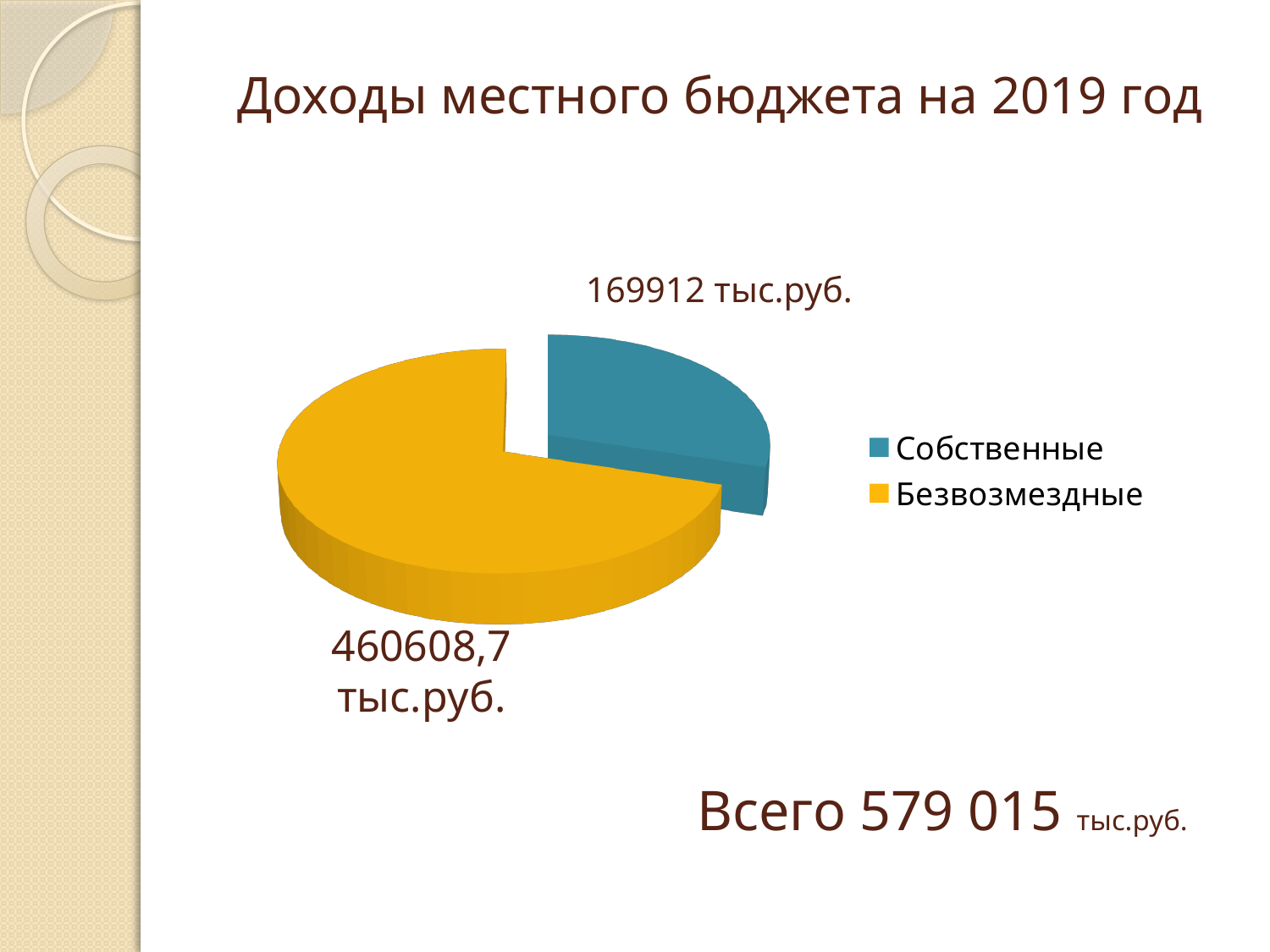
What colour is the Собственные slice? Blue What is the difference between the values for Безвозмездные and Собственные? 290696,7 тыс.руб. What is the title of the chart on the slide? Доходы местного бюджета на 2019 год What total (Всего) is printed on the slide? 579 015 тыс.руб. Which category has the smallest slice of the pie? Собственные Which is larger, Собственные or Безвозмездные? Безвозмездные What value is shown for Безвозмездные? 460608,7 тыс.руб. What value is shown for Собственные? 169912 тыс.руб. Which category has the largest slice of the pie? Безвозмездные What kind of chart is shown on the slide? Pie chart How many entries does the legend list? 2 How many categories does the pie chart show? 2